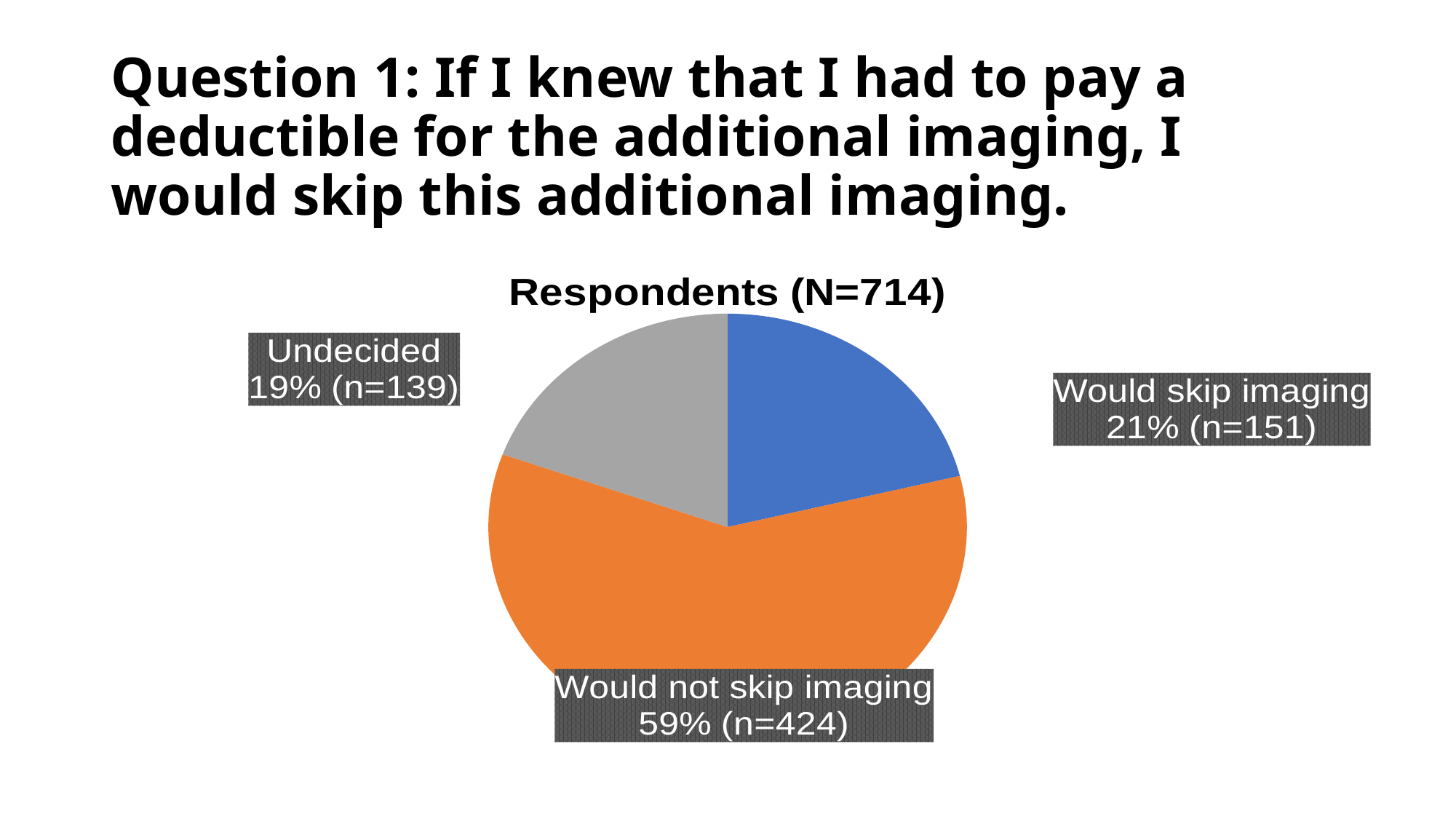
Which category has the largest share of respondents? Would not skip imaging What colour is the 'Would not skip imaging' slice? orange Which category has the smallest share of respondents? Undecided Which has more respondents: 'Would skip imaging' or 'Undecided'? Would skip imaging How many slices does the pie chart have? 3 What percentage of respondents were undecided? 19% What is the difference in number of respondents between 'Would not skip imaging' and 'Would skip imaging'? 273 What type of chart is shown on the slide? pie chart What is the title of the chart? Respondents (N=714) How many respondents would skip imaging? 151 How many respondents would not skip imaging? 424 What percentage of respondents would skip imaging? 21%